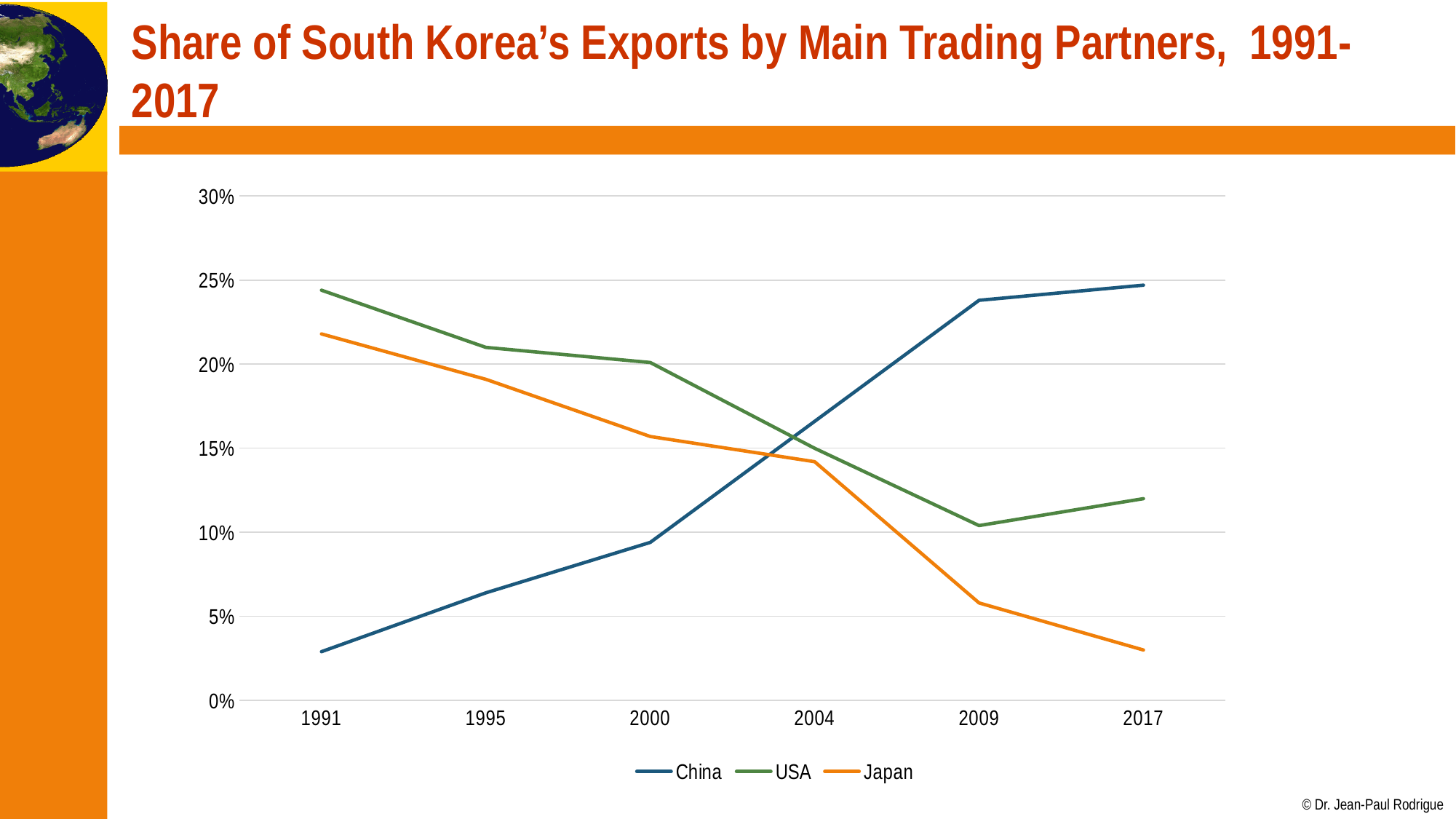
Is the value for China in 1991 greater or less than 5%? less In 2017, which is larger: the share for China or the share for USA? China How many series does the legend list? 3 Which trading partner has the lowest share in 1991? China Does the Japan line rise or fall from 1991 to 2017? Falls Is the value for China in 2009 greater or less than 20%? greater Which trading partner has the highest share in 2009? China Is the value for USA in 1991 greater or less than 20%? greater How many years are shown on the x axis? 6 Does the China line rise or fall from 1991 to 2017? Rises What kind of chart is shown on the slide? Line chart